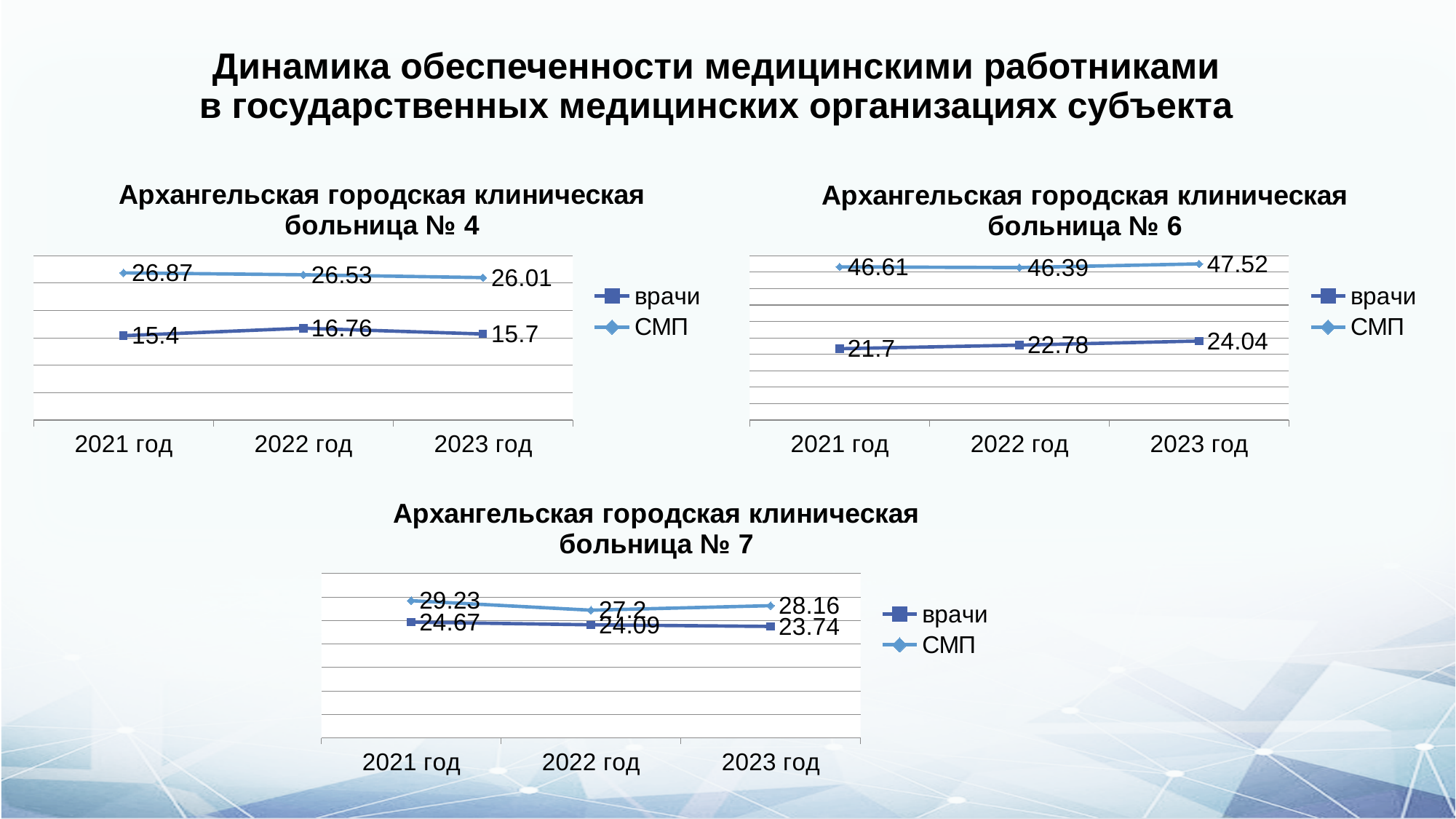
In the chart titled "Архангельская городская клиническая больница № 6", what is the value for СМП in 2023 год? 47.52 In the chart titled "Архангельская городская клиническая больница № 7", which is larger in 2023 год: врачи or СМП? СМП In the chart titled "Архангельская городская клиническая больница № 4", does the value for СМП rise or fall from 2021 год to 2023 год? fall What kind of chart is the one titled "Архангельская городская клиническая больница № 4"? line chart How many series does the legend list in the chart titled "Архангельская городская клиническая больница № 7"? 2 In the chart titled "Архангельская городская клиническая больница № 4", what is the value for врачи in 2022 год? 16.76 In the chart titled "Архангельская городская клиническая больница № 7", what is the value for врачи in 2021 год? 24.67 In the chart titled "Архангельская городская клиническая больница № 6", by how much did the value for врачи increase from 2021 год to 2023 год? 2.34 In the chart titled "Архангельская городская клиническая больница № 6", in which year is the value for врачи highest? 2023 год In the chart titled "Архангельская городская клиническая больница № 6", does the value for врачи rise or fall from 2021 год to 2023 год? rise In the chart titled "Архангельская городская клиническая больница № 7", in which year is the value for СМП lowest? 2022 год In the chart titled "Архангельская городская клиническая больница № 4", what is the difference between the СМП values for 2021 год and 2023 год? 0.86